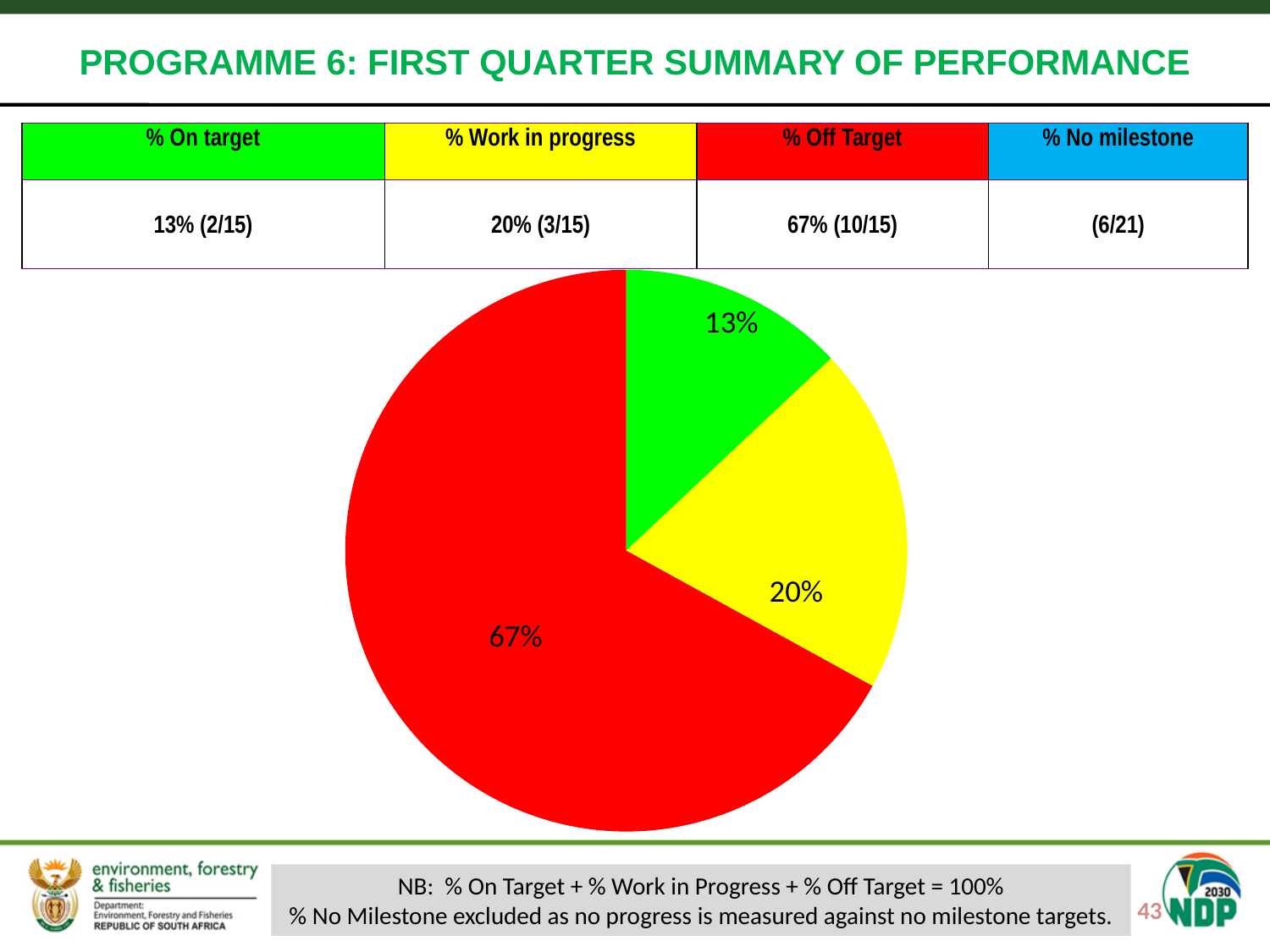
How many slices does the pie chart have? 3 Which colour represents % Off Target in the pie chart? red Which is larger in the pie chart, the yellow slice or the green slice? the yellow slice (20%) What percentage is shown on the yellow slice of the pie chart? 20% What percentage is shown on the red slice of the pie chart? 67% Which slice of the pie chart is the largest? 67% (red, Off Target) What kind of chart is shown on the slide? pie chart What share of the pie does the Off Target category take? 67% What percentage is shown on the green slice of the pie chart? 13% What is the difference between the largest and smallest slices of the pie chart? 54% Which slice of the pie chart is the smallest? 13% (green, On target) What is the difference between the Work in progress and On target percentages shown in the pie chart? 7%